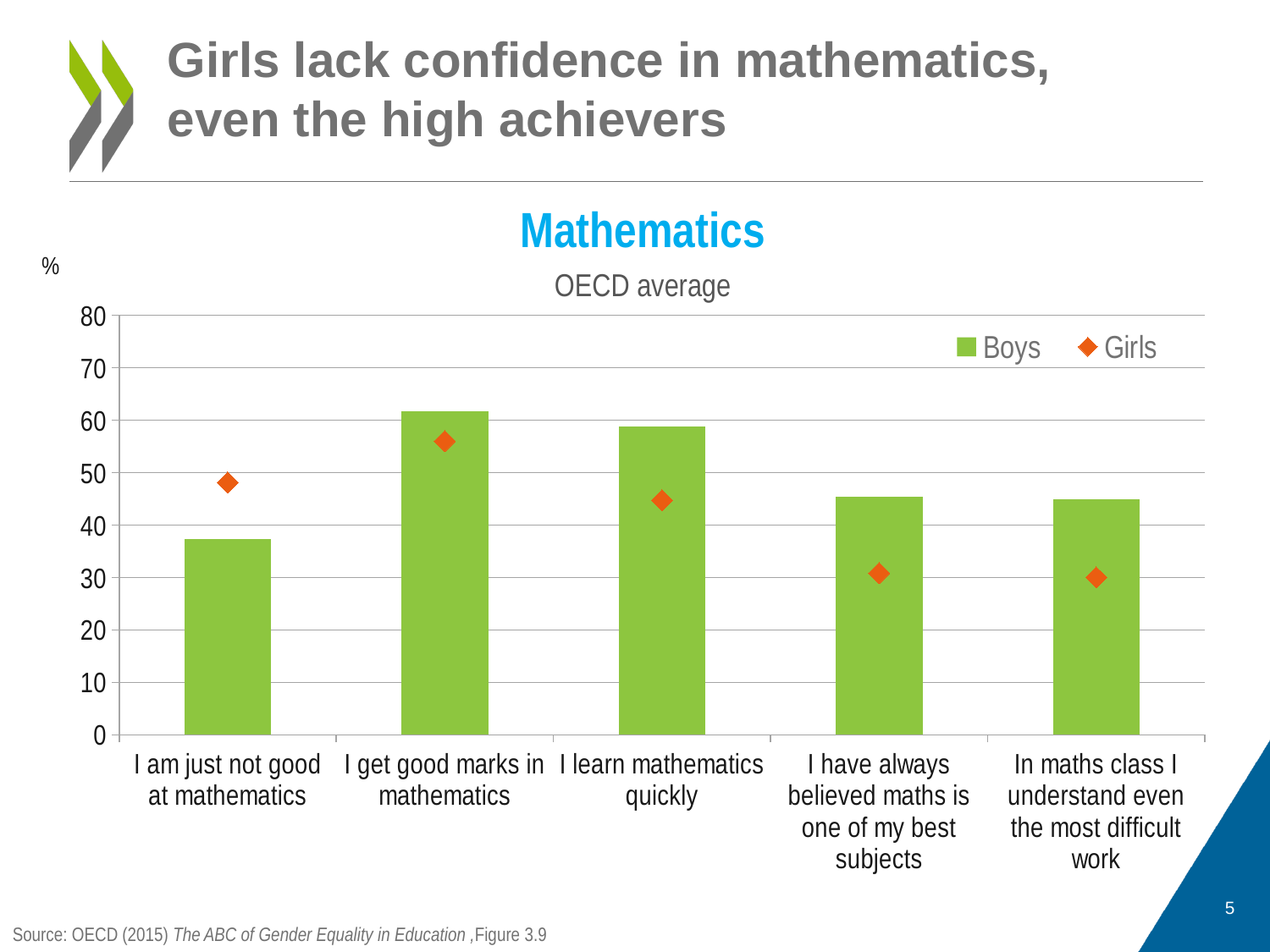
For which statement is the Boys value the lowest? I am just not good at mathematics For which statement is the Girls value the highest? I get good marks in mathematics Is the Boys value for 'I learn mathematics quickly' greater or less than 50? greater What kind of chart is used to show the Boys series? Bar chart Is the Girls value for 'In maths class I understand even the most difficult work' greater or less than 40? less For which statement is the Boys value the highest? I get good marks in mathematics For the statement 'I am just not good at mathematics', which is larger, the Boys value or the Girls value? Girls For the statement 'I have always believed maths is one of my best subjects', which is larger, the Boys value or the Girls value? Boys How many statement categories are shown on the x axis of the chart? 5 Is the Boys value for 'I am just not good at mathematics' greater or less than 40? less How many series does the chart legend list? 2 What is the subtitle shown below the chart title 'Mathematics'? OECD average